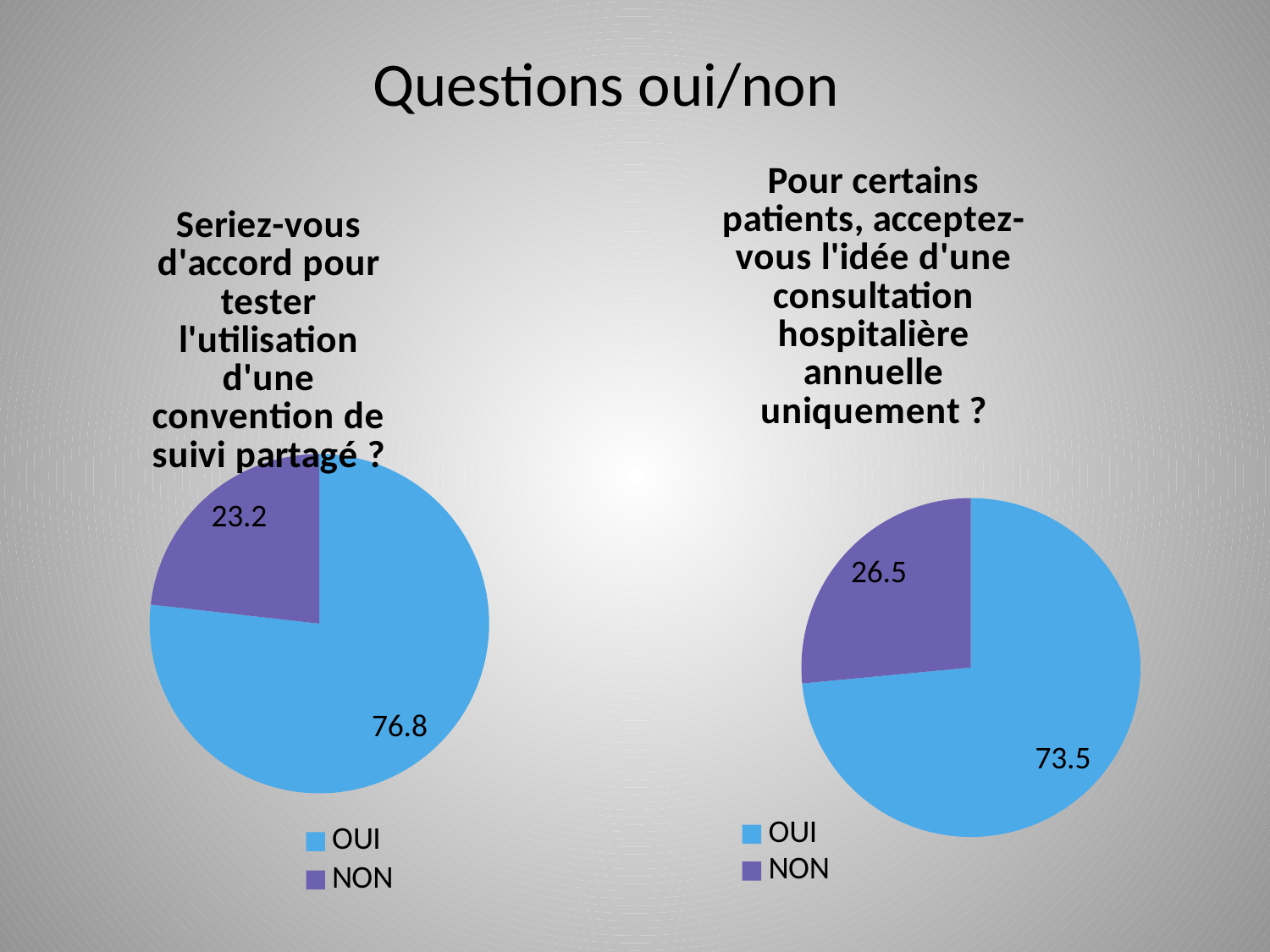
In the right pie chart ("Pour certains patients, acceptez-vous l'idée d'une consultation hospitalière annuelle uniquement ?"), what is the value for NON? 26.5 Which is larger: the OUI value in the left pie chart or the OUI value in the right pie chart? The left pie chart (76.8) How many categories does the legend of the right pie chart list? 2 In the right pie chart, which category has the smallest slice? NON What type of chart is used on the left of the slide? Pie chart In the left pie chart, which category has the largest slice? OUI In the right pie chart ("Pour certains patients, acceptez-vous l'idée d'une consultation hospitalière annuelle uniquement ?"), what is the value for OUI? 73.5 In the left pie chart ("Seriez-vous d'accord pour tester l'utilisation d'une convention de suivi partagé ?"), what is the value for NON? 23.2 In the right pie chart, what is the difference between the OUI and NON values? 47 In the left pie chart, what is the difference between the OUI and NON values? 53.6 In the right pie chart, which colour represents NON? Purple In the left pie chart ("Seriez-vous d'accord pour tester l'utilisation d'une convention de suivi partagé ?"), what is the value for OUI? 76.8